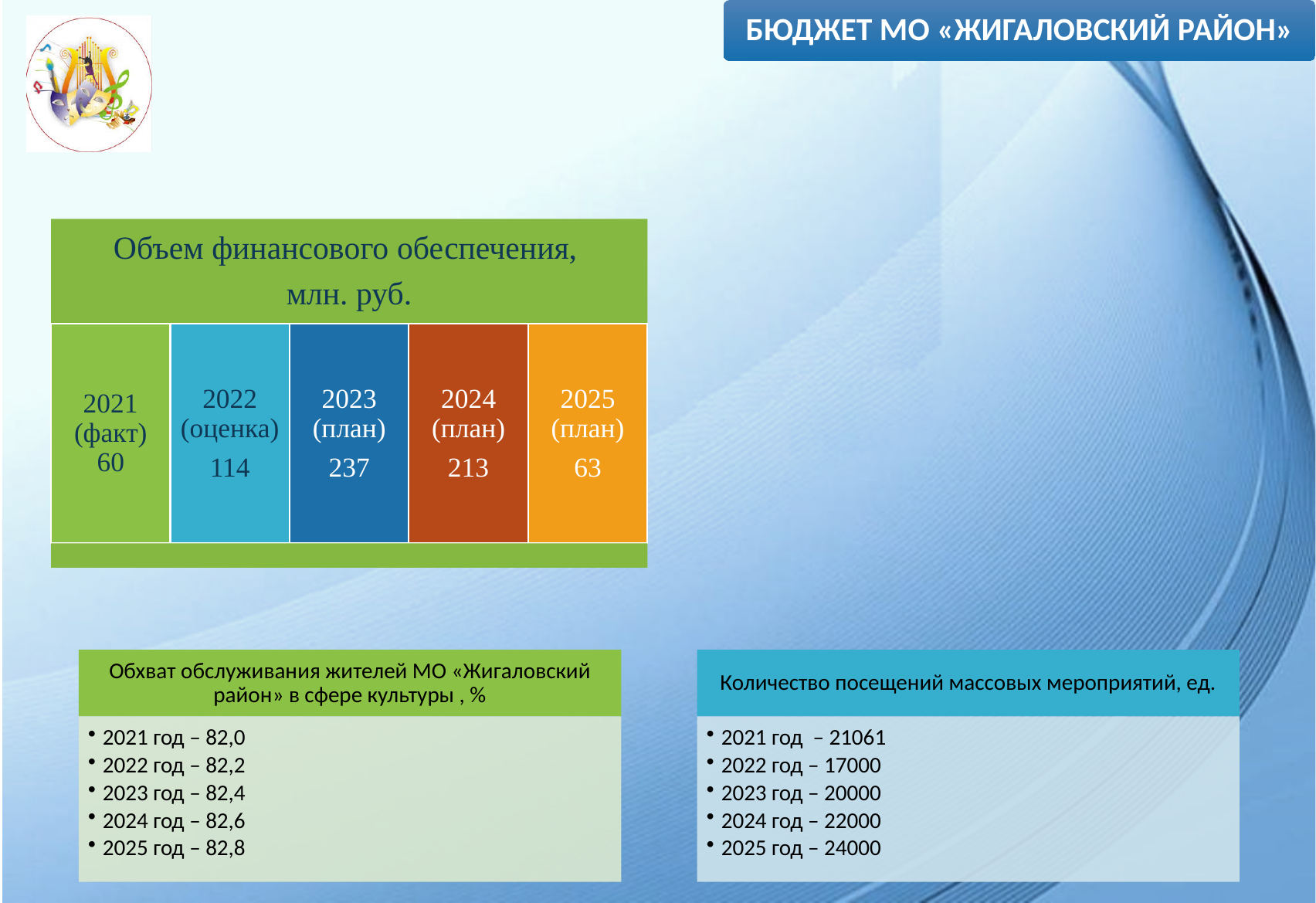
In the 'Объем финансового обеспечения, млн. руб.' graphic, which is larger: the value for 2022 (оценка) or the value for 2025 (план)? 2022 (оценка) In the 'Объем финансового обеспечения, млн. руб.' graphic, what is the value for 2023 (план)? 237 In the 'Объем финансового обеспечения, млн. руб.' graphic, what is the difference between the 2022 (оценка) and 2021 (факт) values? 54 In the 'Объем финансового обеспечения, млн. руб.' graphic, what is the value for 2022 (оценка)? 114 What unit is stated in the title of the 'Объем финансового обеспечения' graphic? млн. руб. In the 'Объем финансового обеспечения, млн. руб.' graphic, which year has the highest value? 2023 (план) In the 'Объем финансового обеспечения, млн. руб.' graphic, what is the value for 2024 (план)? 213 In the 'Объем финансового обеспечения, млн. руб.' graphic, what is the difference between the 2023 (план) and 2024 (план) values? 24 In the 'Объем финансового обеспечения, млн. руб.' graphic, which year has the lowest value? 2021 (факт) In the 'Объем финансового обеспечения, млн. руб.' graphic, what is the value for 2021 (факт)? 60 In the 'Объем финансового обеспечения, млн. руб.' graphic, what is the value for 2025 (план)? 63 How many years are shown in the 'Объем финансового обеспечения, млн. руб.' graphic? 5